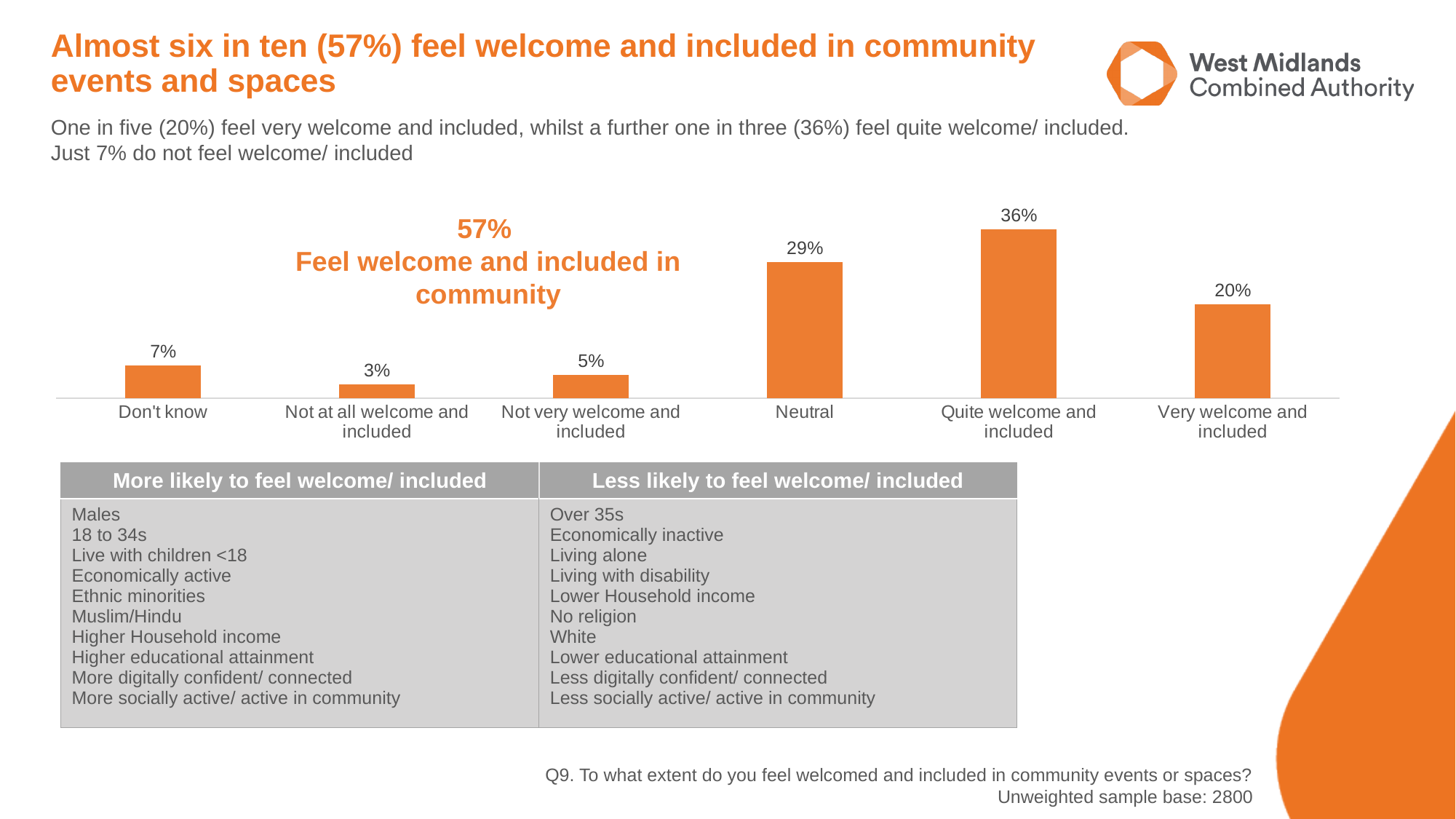
What percentage of respondents answered 'Neutral'? 29% Which category has the highest value? Quite welcome and included Which category has the lowest value? Not at all welcome and included What is the difference between 'Neutral' and 'Not very welcome and included'? 24 percentage points What is the value for 'Don't know'? 7% What is the difference between 'Quite welcome and included' and 'Very welcome and included'? 16 percentage points Which is larger, 'Don't know' or 'Not very welcome and included'? Don't know How many categories are shown on the x axis of the chart? 6 What percentage is highlighted in the orange text annotation on the chart as feeling welcome and included in community? 57% What kind of chart is shown on the slide? Bar chart What is the value for 'Very welcome and included'? 20% What is the value for 'Not at all welcome and included'? 3%